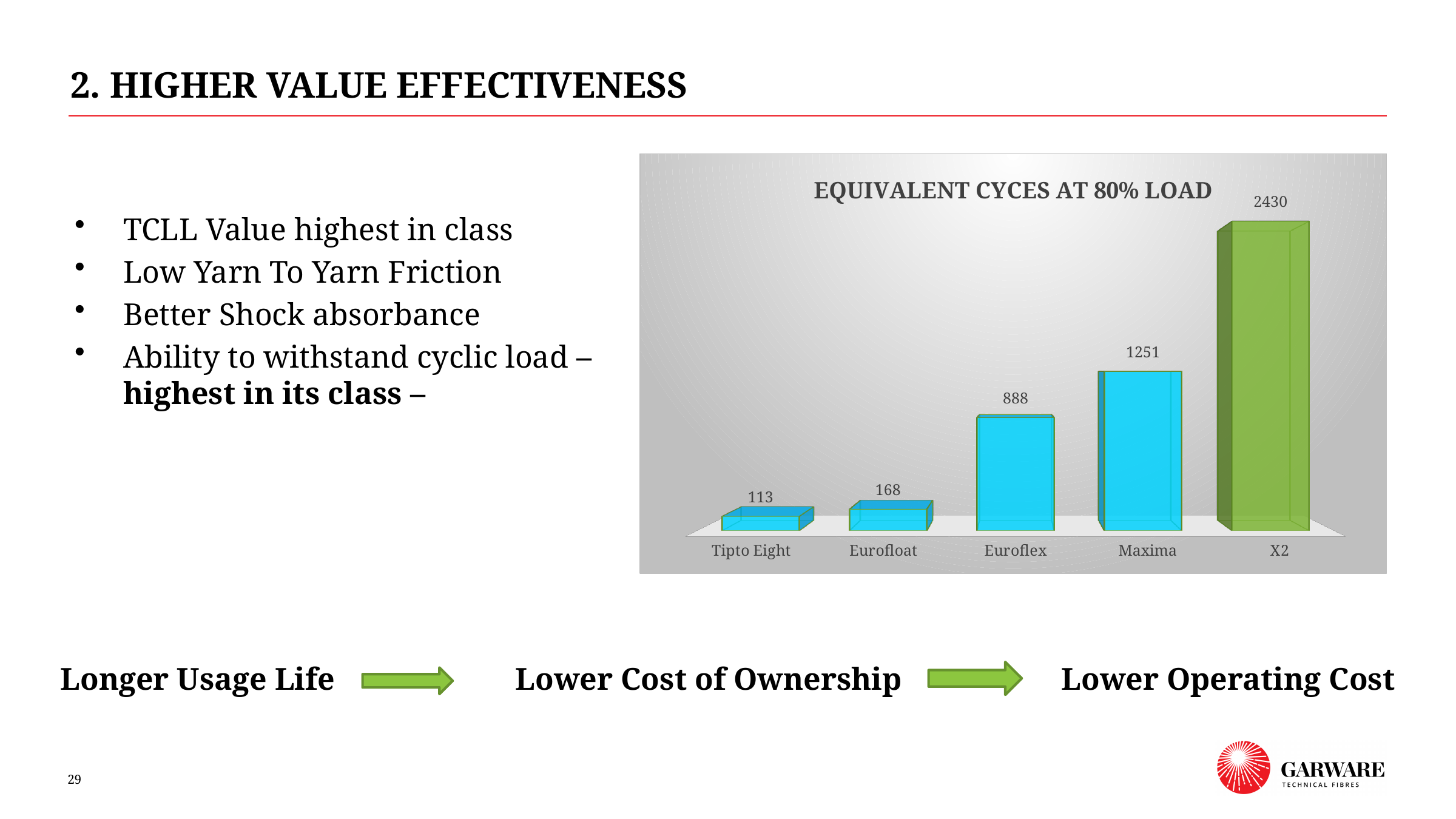
What is the title of the chart? EQUIVALENT CYCES AT 80% LOAD Do the values rise or fall from left to right across the categories? Rise Which category has the highest value in the chart? X2 What kind of chart is shown on the slide? Bar chart What is the value for Euroflex in the chart? 888 Which category has the lowest value in the chart? Tipto Eight What is the value for X2 in the chart? 2430 How many categories are shown in the chart? 5 What is the difference between the values for Eurofloat and Tipto Eight? 55 What is the difference between the values for X2 and Maxima? 1179 What is the value for Tipto Eight in the chart? 113 Which has a larger value, Maxima or Euroflex? Maxima